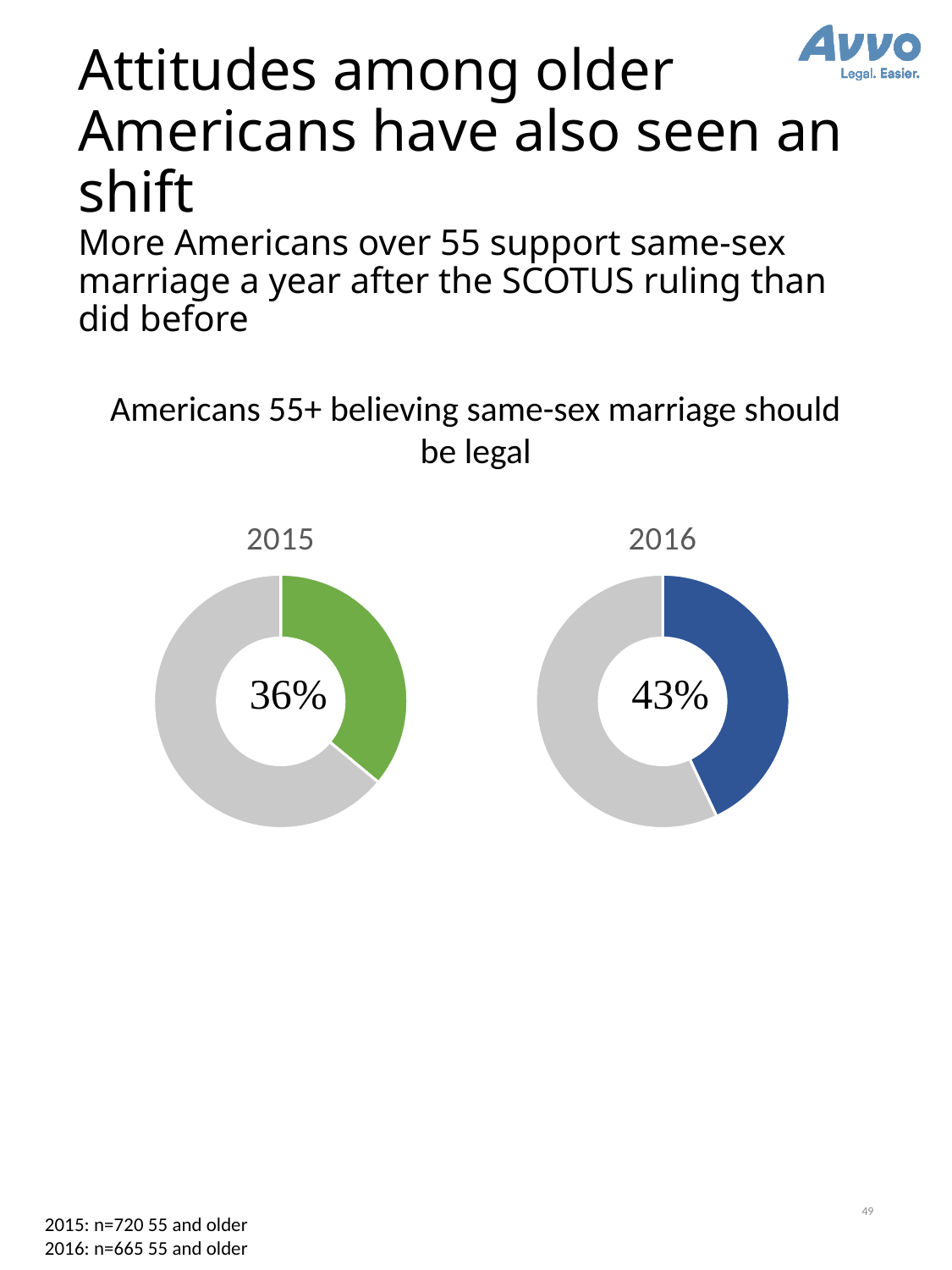
Did the share of Americans 55+ believing same-sex marriage should be legal rise or fall from 2015 to 2016? Rise How many donut charts are shown on the slide? 2 By how many percentage points did the share of Americans 55+ believing same-sex marriage should be legal change from 2015 to 2016? 7 percentage points In the 2016 donut chart, what percentage of Americans 55+ believed same-sex marriage should be legal? 43% Which year shows the higher share of Americans 55+ believing same-sex marriage should be legal, 2015 or 2016? 2016 In the 2015 donut chart, what percentage of Americans 55+ believed same-sex marriage should be legal? 36% What colour is the highlighted segment in the 2016 donut chart? Blue What type of chart is used to show the 2015 and 2016 values? Donut chart Is the 2015 value in the donut chart greater or less than 50%? less Which year's donut chart shows the lower percentage? 2015 What is the title of the chart on the slide? Americans 55+ believing same-sex marriage should be legal